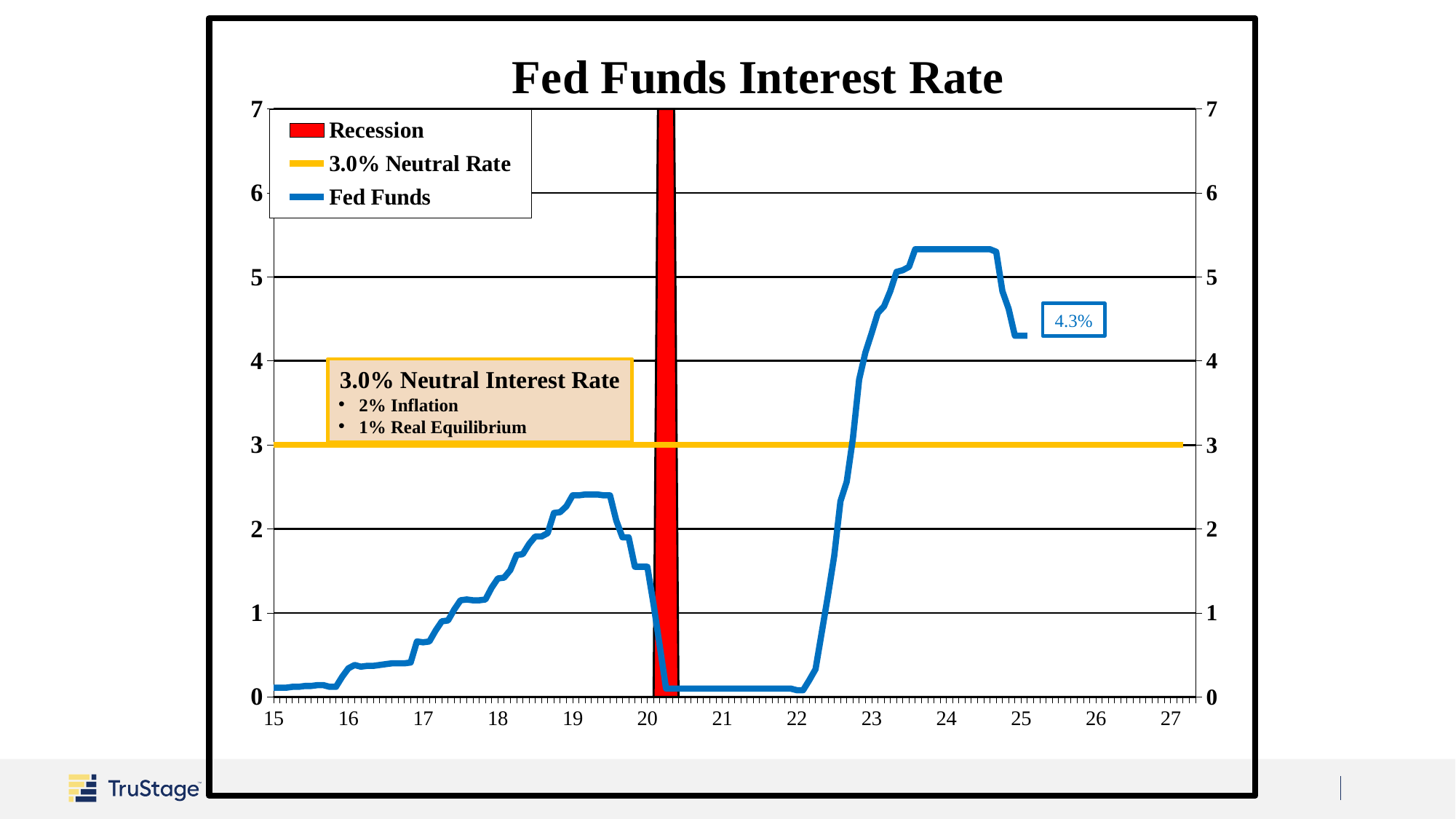
Is the Fed Funds value at 24 greater or less than 5? greater Is the Fed Funds value at 19 greater or less than 2? greater Is the final labelled Fed Funds value of 4.3% above or below the 3.0% neutral rate line? above What is the value of the neutral rate line shown on the chart? 3.0% Is the Fed Funds value at 21 greater or less than 1? less What colour is the Fed Funds line? blue How many entries does the chart legend list? 3 What is the title of the chart? Fed Funds Interest Rate What kind of chart is shown on the slide? line chart Does the Fed Funds line rise or fall between 22 and 23? rise Which is higher, the Fed Funds value at 24 or at 19? 24 What is the labelled value of the Fed Funds line at the end of the series (around 25)? 4.3%